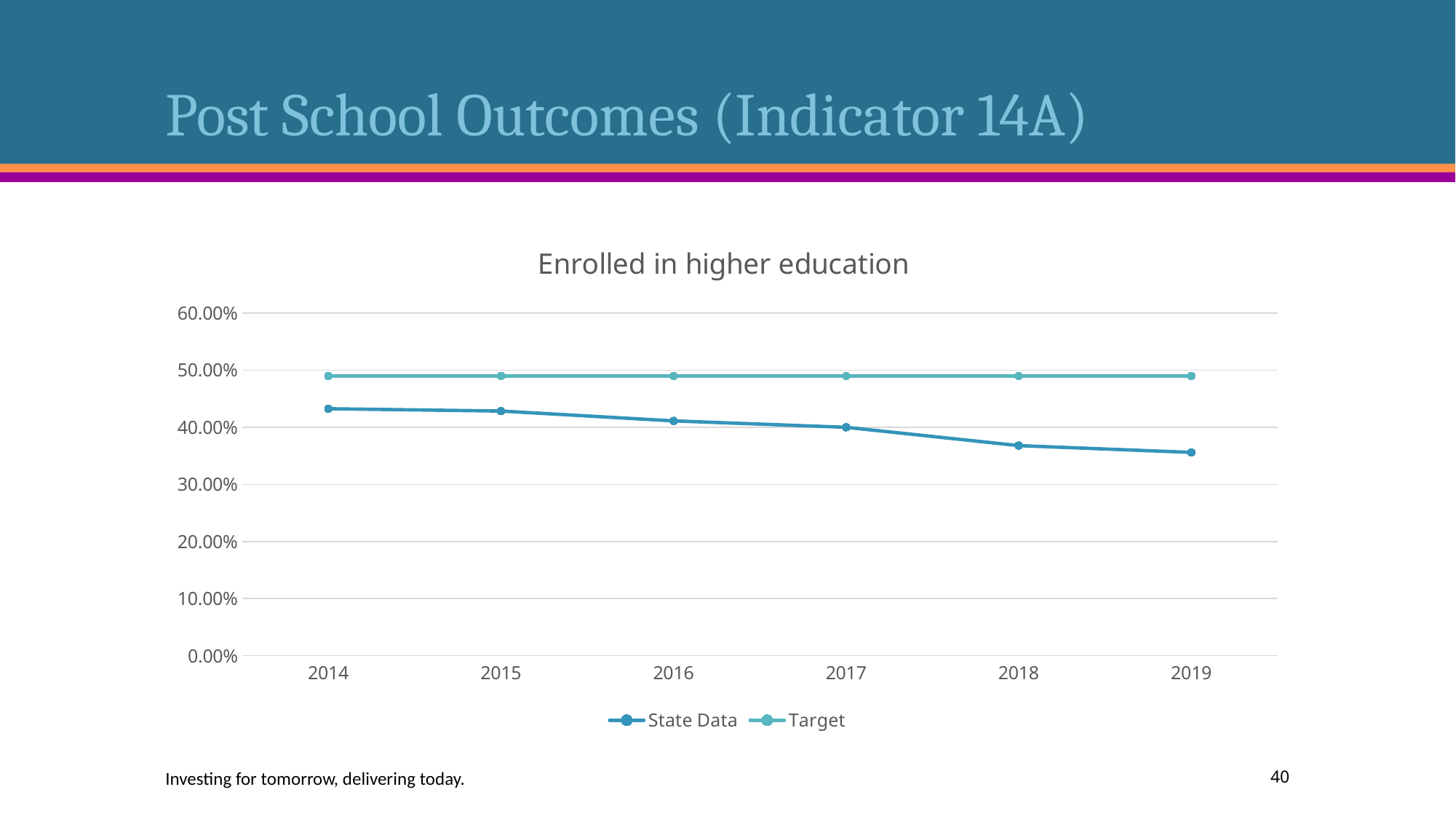
Is the State Data value for 2019 greater or less than 40.00%? less Does the State Data series rise or fall from 2014 to 2019? fall What are the two series named in the legend? State Data and Target In which year is the State Data value highest? 2014 How many series does the legend list? 2 Is the State Data value for 2014 greater or less than 40.00%? greater Is the Target value for 2016 greater or less than 40.00%? greater In which year is the State Data value lowest? 2019 In 2019, which is larger: State Data or Target? Target What is the title of the chart? Enrolled in higher education How many years are plotted along the x axis? 6 What kind of chart is shown on the slide? line chart